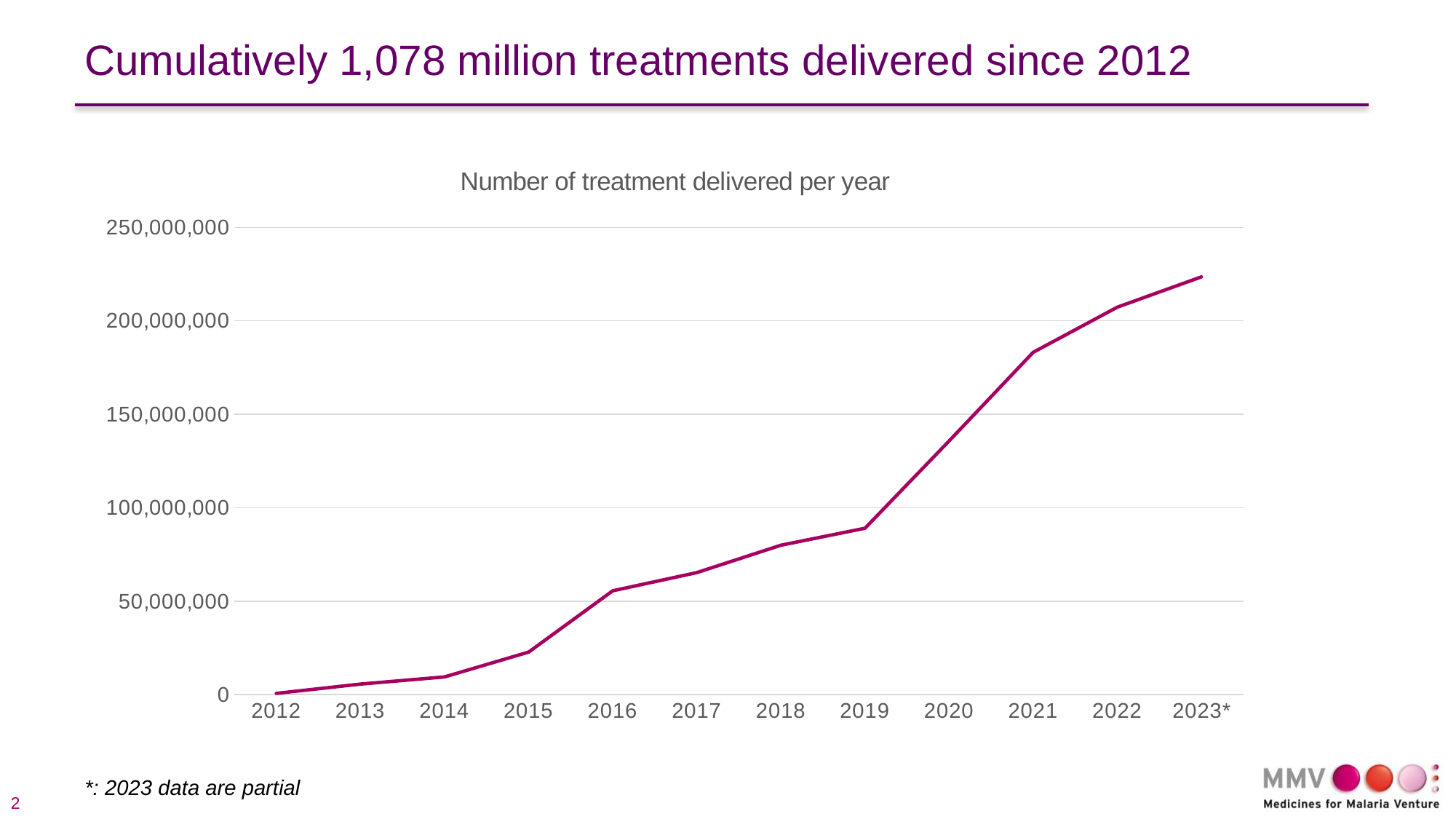
Is the value for 2016 greater or less than 50,000,000? greater What kind of chart is shown on the slide? line chart Is the value for 2021 greater or less than 150,000,000? greater Is the value for 2023* greater or less than 250,000,000? less Do the values rise or fall from 2012 to 2023*? rise Which year has the larger value, 2018 or 2021? 2021 What is the title of the chart? Number of treatment delivered per year Which year has the highest number of treatments delivered? 2023* Which year has the lowest number of treatments delivered? 2012 How many years are plotted on the x axis of the chart? 12